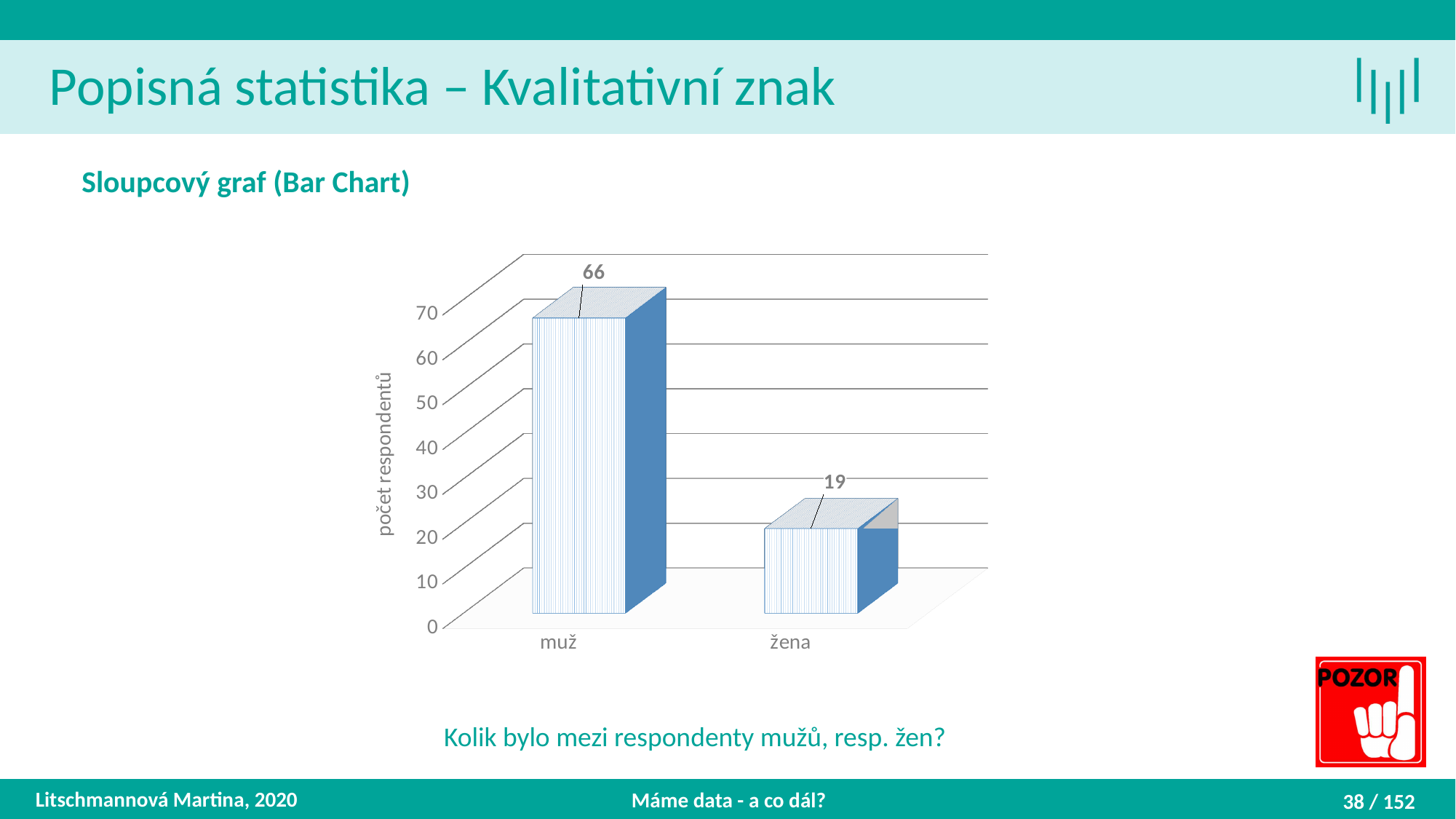
What is the label of the vertical axis? počet respondentů Which is larger, the value for muž or the value for žena? muž Is the value for žena greater or less than 20? less What is the difference between the values for muž and žena? 47 What is the highest tick value shown on the vertical axis? 70 Is the value for muž greater or less than 60? greater Which category has the lowest value? žena How many categories are shown on the x axis? 2 What is the value for žena? 19 What is the value for muž? 66 Which category has the highest value? muž What kind of chart is shown on the slide? bar chart